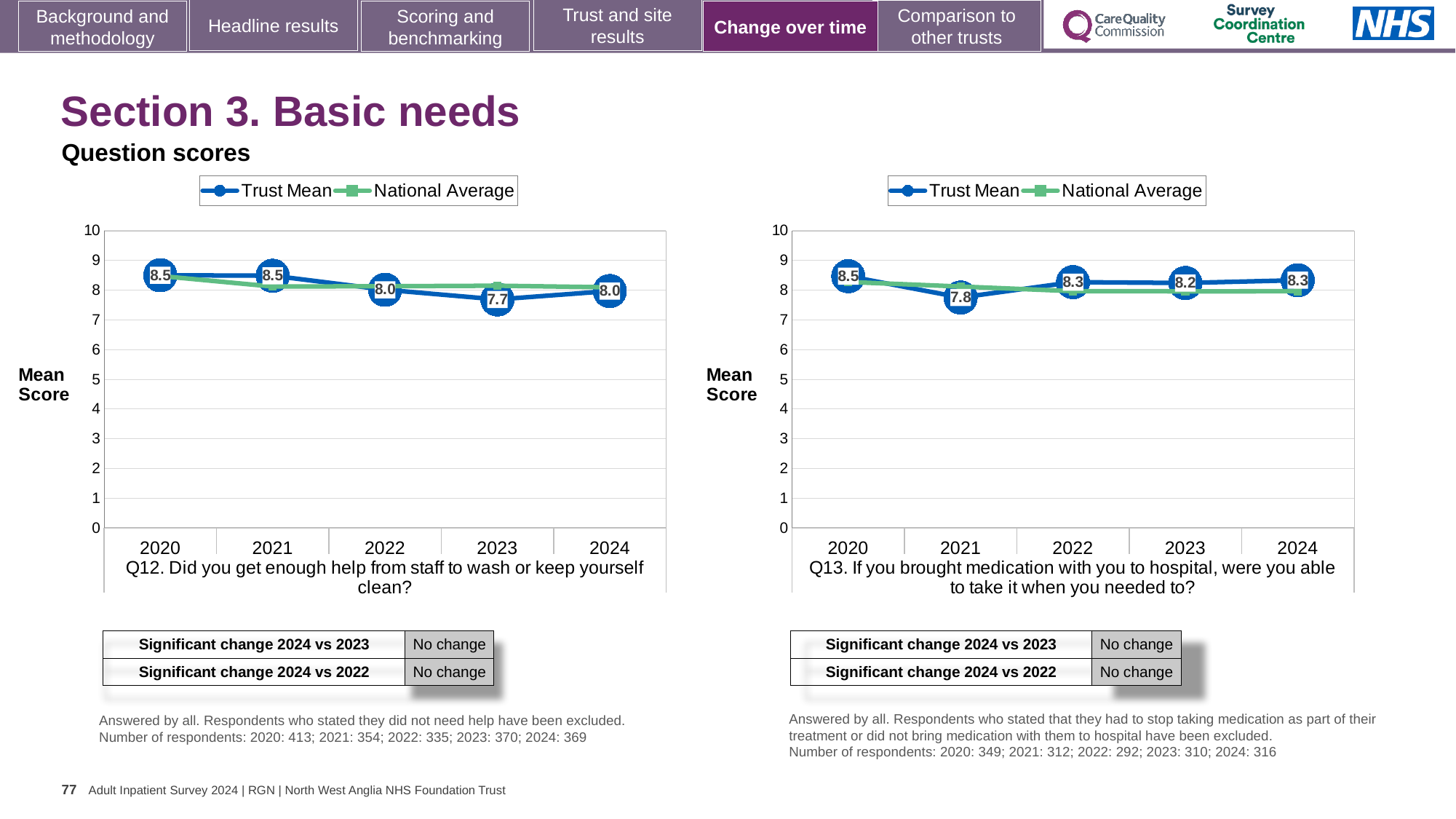
In the Q12 chart (left), what is the difference between the Trust Mean for 2021 and 2023? 0.8 What type of chart is the Q13 chart (right)? Line chart In the Q13 chart (right), is the Trust Mean for 2021 larger or smaller than the Trust Mean for 2022? smaller How many series does the legend of the Q12 chart (left) list? 2 In the Q13 chart (right), what is the Trust Mean for 2024? 8.3 In the Q12 chart (left), which year has the lowest Trust Mean? 2023 In the Q13 chart (right), what is the Trust Mean for 2021? 7.8 In the Q12 chart (left), what is the Trust Mean for 2020? 8.5 In the Q13 chart (right), what is the difference between the Trust Mean for 2020 and 2021? 0.7 In the Q12 chart (left), how many years are plotted on the x axis? 5 In the Q12 chart (left), what is the Trust Mean for 2023? 7.7 In the Q13 chart (right), which year has the highest Trust Mean? 2020